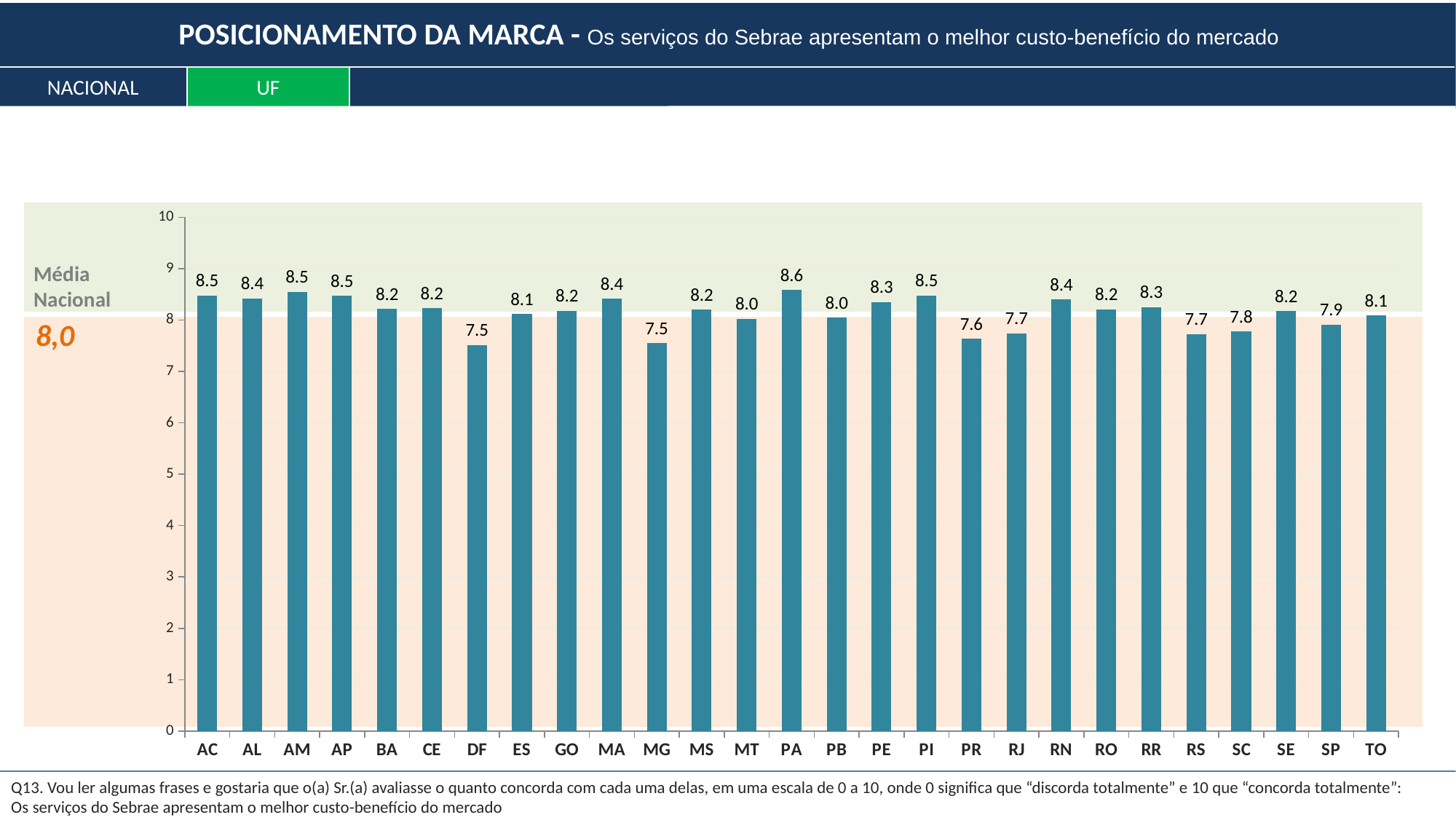
What is the difference between the values for AM and PR? 0.9 What is the value for DF? 7.5 Which is larger, the value for AM or the value for MG? AM Is the value for RJ greater or less than 8? less What is the Média Nacional value shown beside the chart? 8,0 Which state has the highest value? PA What is the value for SP? 7.9 What is the value for PA? 8.6 How many states are shown on the x axis? 27 What is the difference between the values for PA and DF? 1.1 What kind of chart is shown on the slide? bar chart What is the value for RN? 8.4